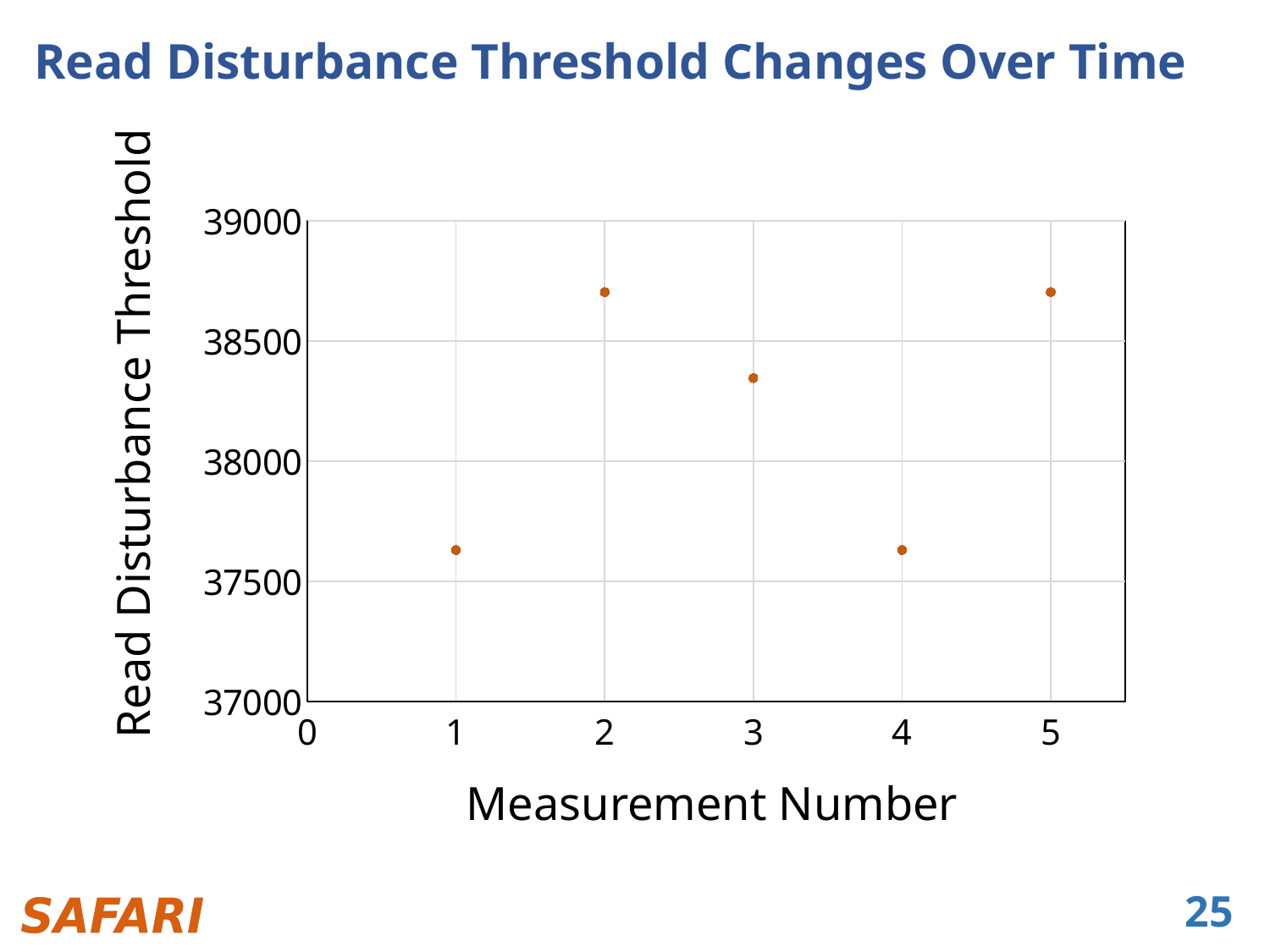
Is the Read Disturbance Threshold for Measurement Number 5 greater or less than 38500? greater Is the Read Disturbance Threshold for Measurement Number 2 greater or less than 38500? greater What is the label of the x axis? Measurement Number How many data points are plotted on the chart? 5 What is the title of the chart? Read Disturbance Threshold Changes Over Time Which has a higher Read Disturbance Threshold, Measurement Number 2 or Measurement Number 3? Measurement Number 2 Is the Read Disturbance Threshold for Measurement Number 3 greater or less than 38500? less What kind of chart is shown on the slide? scatter plot Which has a higher Read Disturbance Threshold, Measurement Number 1 or Measurement Number 3? Measurement Number 3